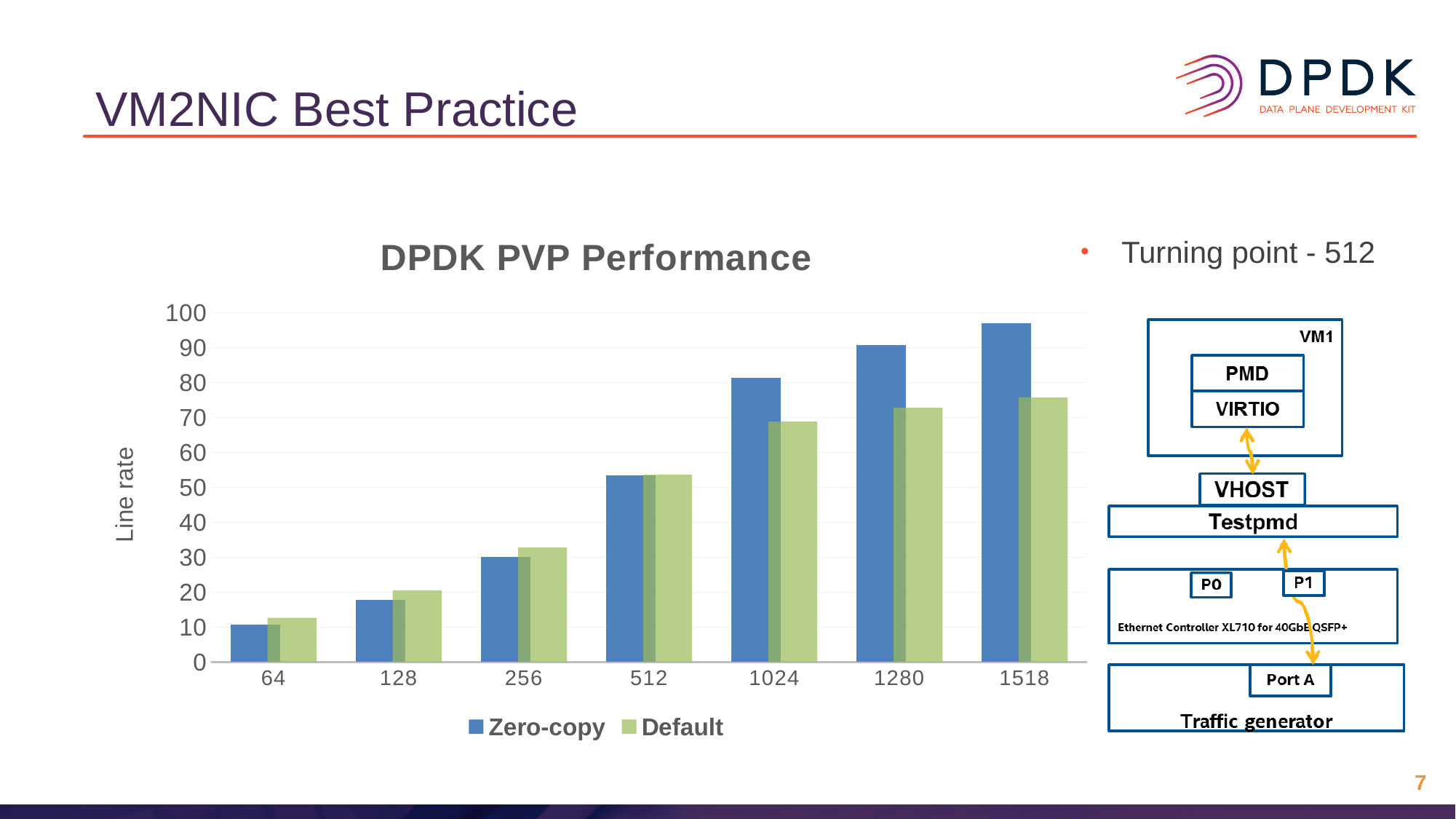
Is the Default value for 1518 greater or less than 80? less Which category has the highest Zero-copy value in the DPDK PVP Performance chart? 1518 How many series does the legend of the DPDK PVP Performance chart list? 2 What is the label on the y axis of the DPDK PVP Performance chart? Line rate Is the Zero-copy value for 1280 greater or less than 80? greater At 1024, which series has the larger value, Zero-copy or Default? Zero-copy Which category has the highest Default value in the DPDK PVP Performance chart? 1518 What kind of chart is the DPDK PVP Performance chart? bar chart Do the Zero-copy values rise or fall as the packet size increases along the x axis? rise At 256, which series has the larger value, Zero-copy or Default? Default Which category has the lowest Zero-copy value in the DPDK PVP Performance chart? 64 How many packet-size categories are shown on the x axis of the DPDK PVP Performance chart? 7